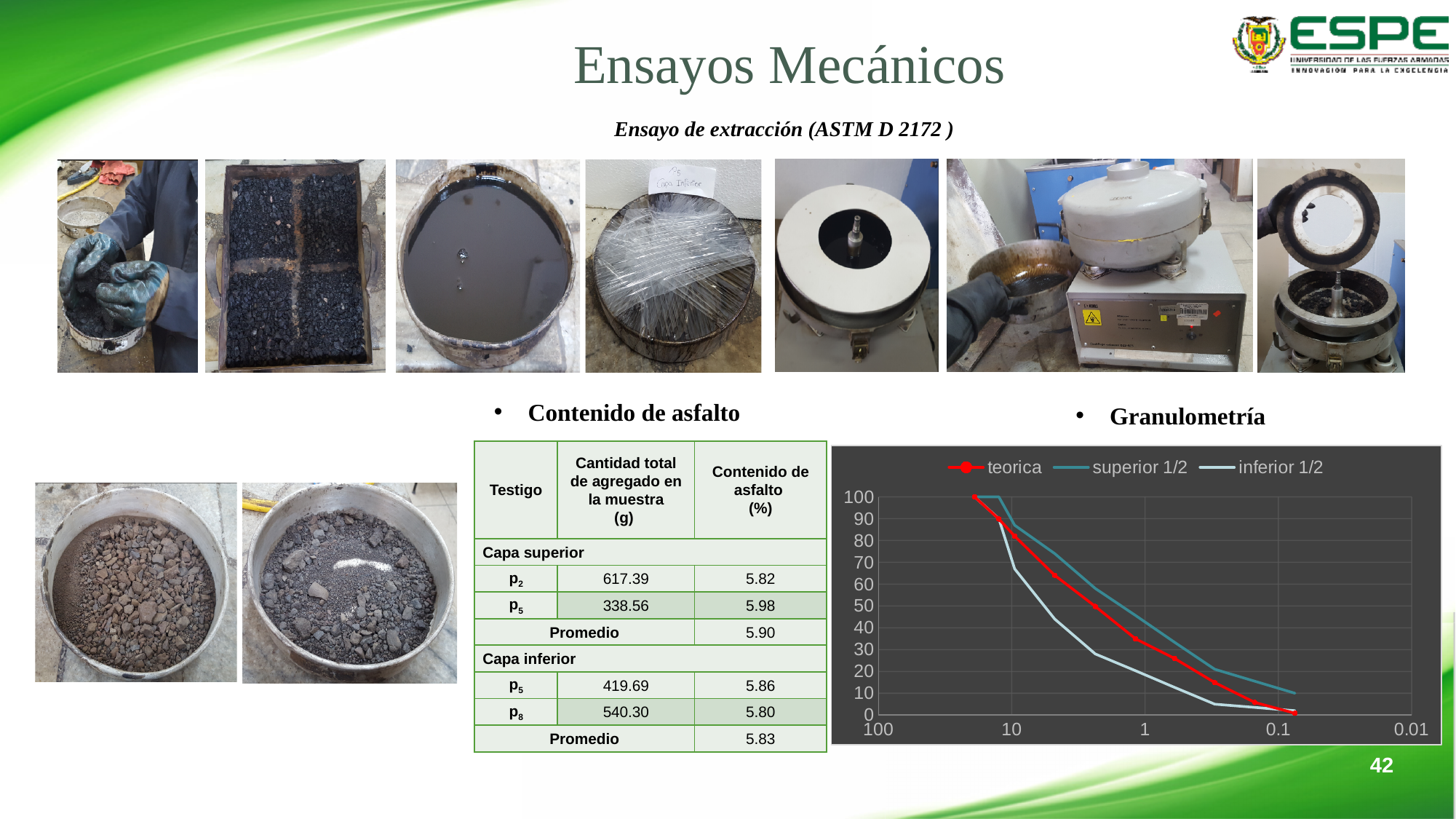
What kind of chart is shown under the heading Granulometría? line chart In the Granulometría chart, which series has the highest value at x = 1? superior 1/2 What are the names of the series in the legend of the Granulometría chart? teorica, superior 1/2, inferior 1/2 In the Granulometría chart, is the value of the teorica series at x = 1 greater or less than 50? less In the Granulometría chart, which series has the lowest value at x = 1? inferior 1/2 In the Granulometría chart, is the value of the superior 1/2 series at x = 1 greater or less than 30? greater How many series does the legend of the Granulometría chart list? 3 In the Granulometría chart, which colour is used for the teorica series? red In the Granulometría chart, is the value of the inferior 1/2 series at x = 1 greater or less than 30? less In the Granulometría chart, at x = 1, which series has the larger value: superior 1/2 or inferior 1/2? superior 1/2 In the Granulometría chart, do the values of the series rise or fall moving from left to right along the x axis? fall